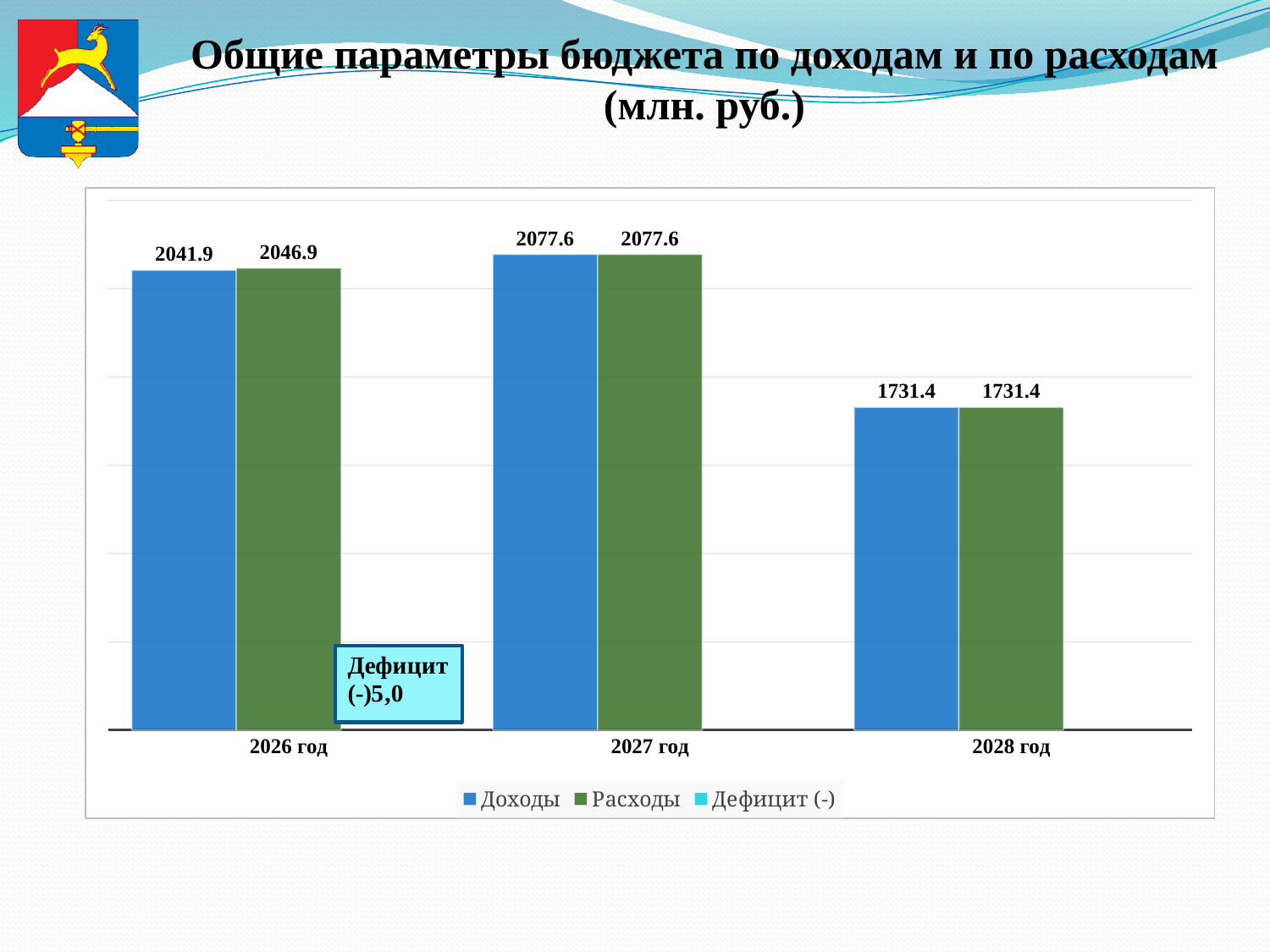
What is the value of Расходы for 2026 год? 2046.9 What is the value of Расходы for 2028 год? 1731.4 In which year is Расходы the lowest? 2028 год What is the value of Доходы for 2026 год? 2041.9 In which year is Доходы the highest? 2027 год Which is larger for 2026 год, Доходы or Расходы? Расходы How many years are shown on the x axis? 3 What is the difference between Доходы for 2027 год and Доходы for 2028 год? 346.2 What is the difference between Расходы and Доходы for 2026 год? 5.0 How many series does the legend list? 3 What is the value of Доходы for 2027 год? 2077.6 What kind of chart is shown on the slide? bar chart